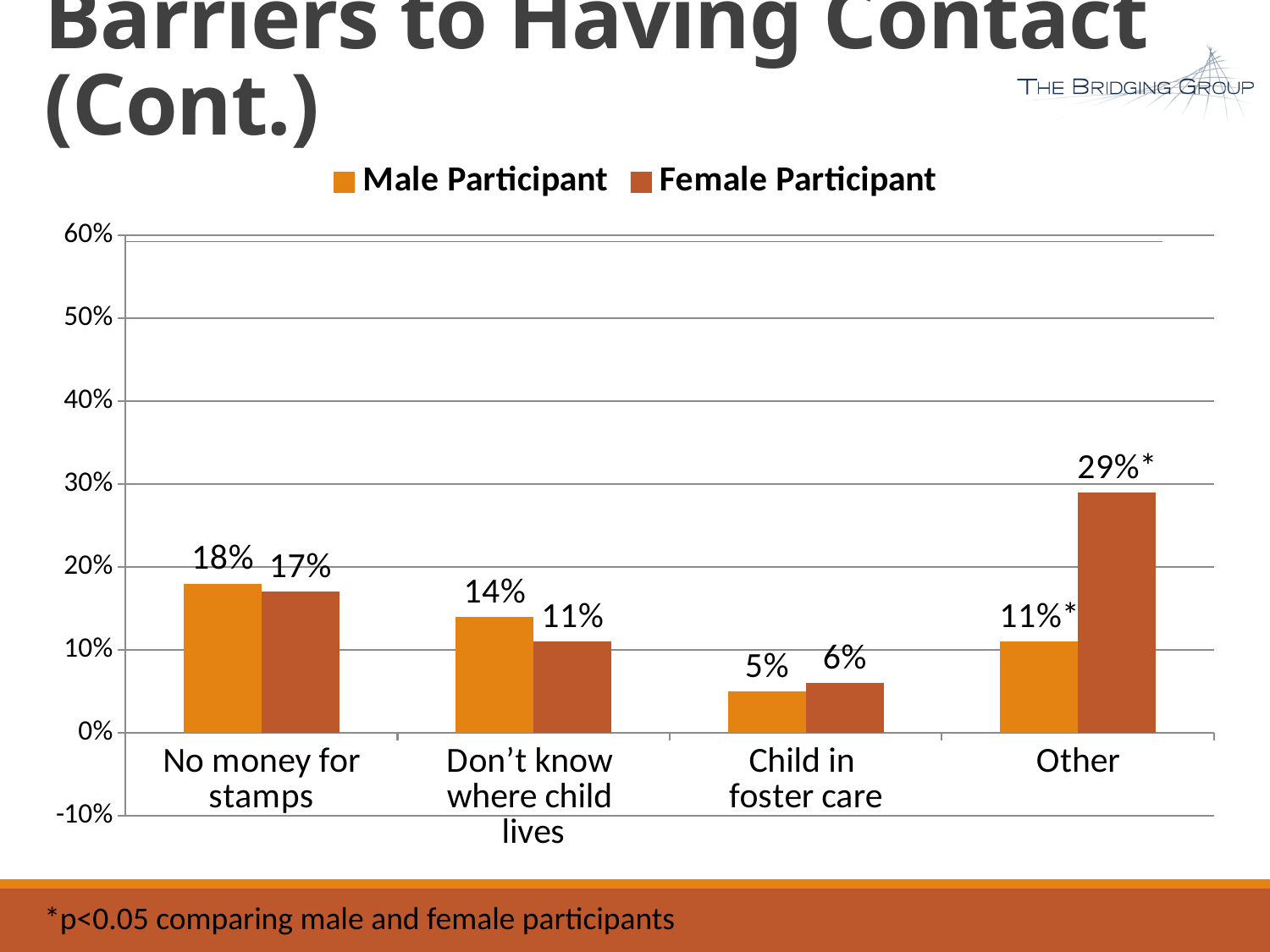
How many categories are shown on the x axis? 4 Which category has the highest Female Participant value? Other What is the value for Female Participant in the 'Other' category? 29% What is the value for Male Participant in the 'No money for stamps' category? 18% What is the value for Female Participant in the 'Child in foster care' category? 6% What is the difference between the Female Participant and Male Participant values in the 'Other' category? 18% How many series does the legend list? 2 What kind of chart is shown on the slide? Bar chart What is the value for Male Participant in the 'Don't know where child lives' category? 14% Which category has the lowest Male Participant value? Child in foster care Which is larger in the 'Don't know where child lives' category: Male Participant or Female Participant? Male Participant Which series is shown in the darker red-brown colour? Female Participant